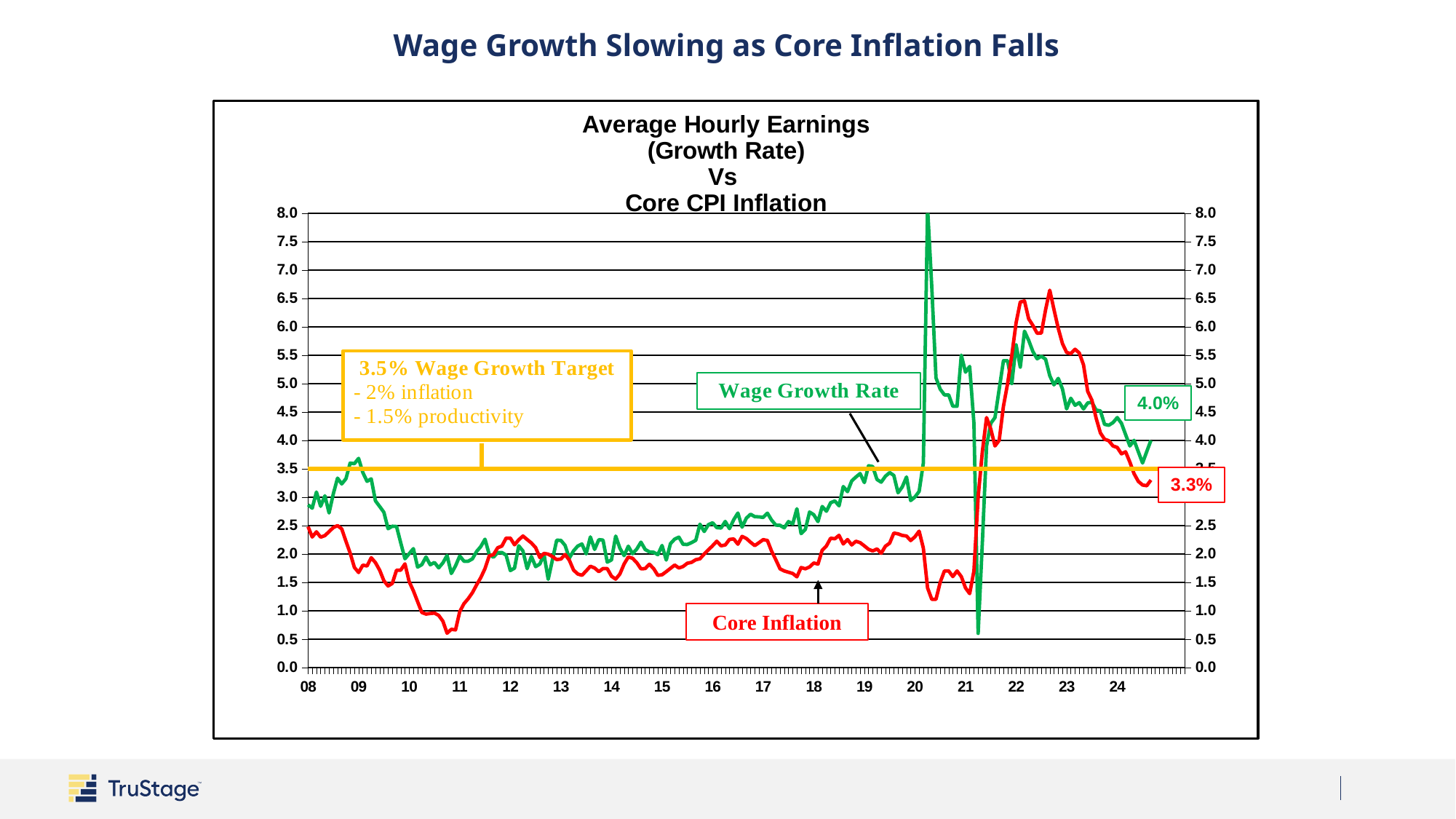
What kind of chart is shown on the slide? line chart What two components make up the 3.5% Wage Growth Target according to the annotation box? 2% inflation and 1.5% productivity Which is larger at the end of the chart, the Wage Growth Rate or Core Inflation? Wage Growth Rate Does Core Inflation rise or fall from its 2022 peak to the end of 2024? fall Which series reaches the highest value anywhere on the chart? Wage Growth Rate Is the peak of Core Inflation in 2022 greater or less than 6.0? greater What is the latest labelled value of the Wage Growth Rate? 4.0% What is the wage growth target shown by the horizontal yellow line? 3.5% What is the difference between the latest labelled Wage Growth Rate (4.0%) and the latest labelled Core Inflation (3.3%)? 0.7% What is the latest labelled value of Core Inflation? 3.3% Is the peak of the Wage Growth Rate around 2020 greater or less than 7.0? greater Is the lowest value of Core Inflation around late 2010 greater or less than 1.0? less